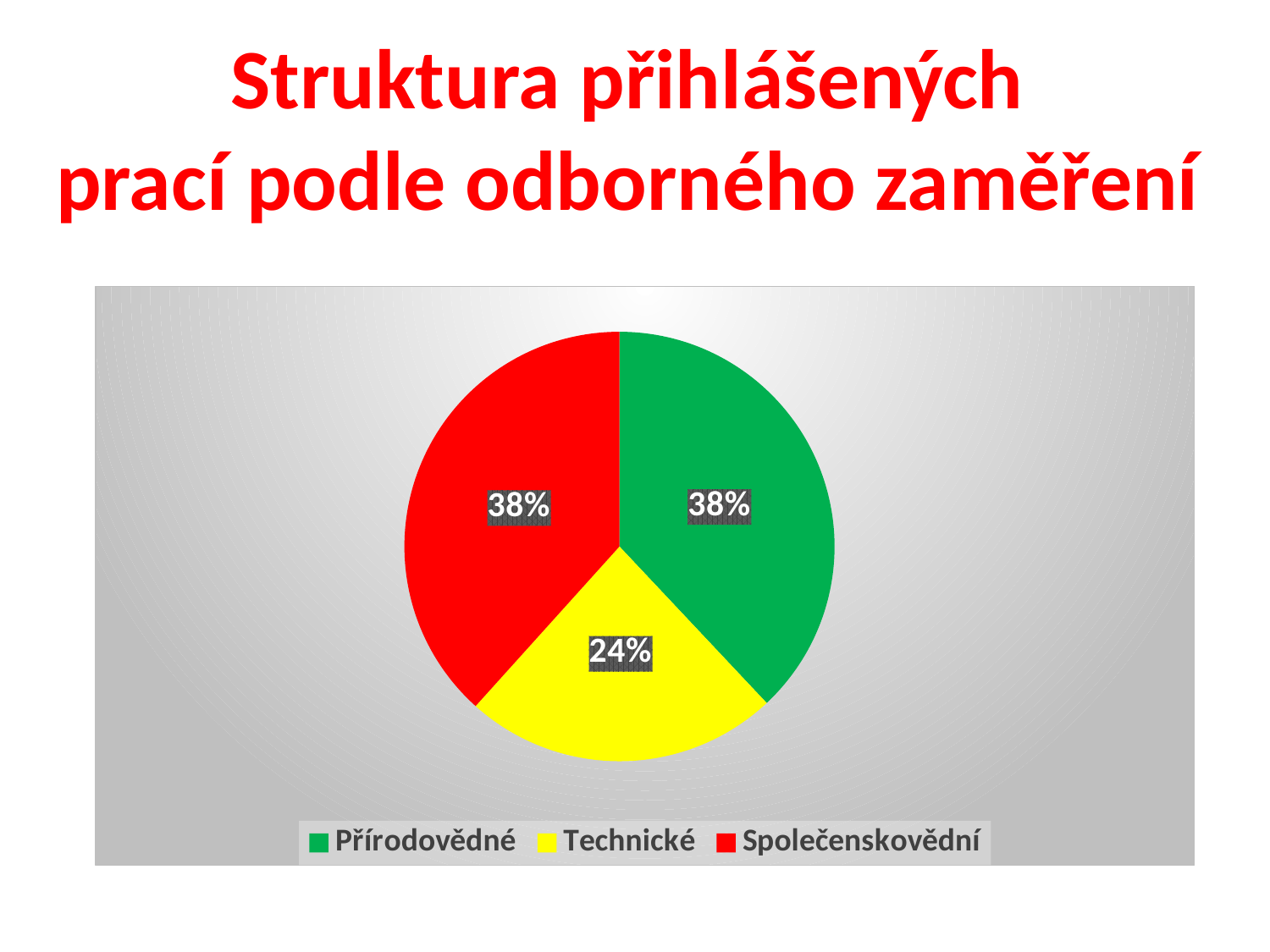
What is the title of the slide? Struktura přihlášených prací podle odborného zaměření What share of the pie does Technické have? 24% What colour is the Technické slice? yellow Which category has the smallest slice of the pie? Technické What is the difference in percentage points between Přírodovědné and Technické? 14 How many entries does the legend list? 3 Which is larger, the share for Společenskovědní or the share for Technické? Společenskovědní Is the share for Technické greater or less than 30%? less How many slices does the pie chart have? 3 What kind of chart is shown on the slide? pie chart What share of the pie does Přírodovědné have? 38% What share of the pie does Společenskovědní have? 38%